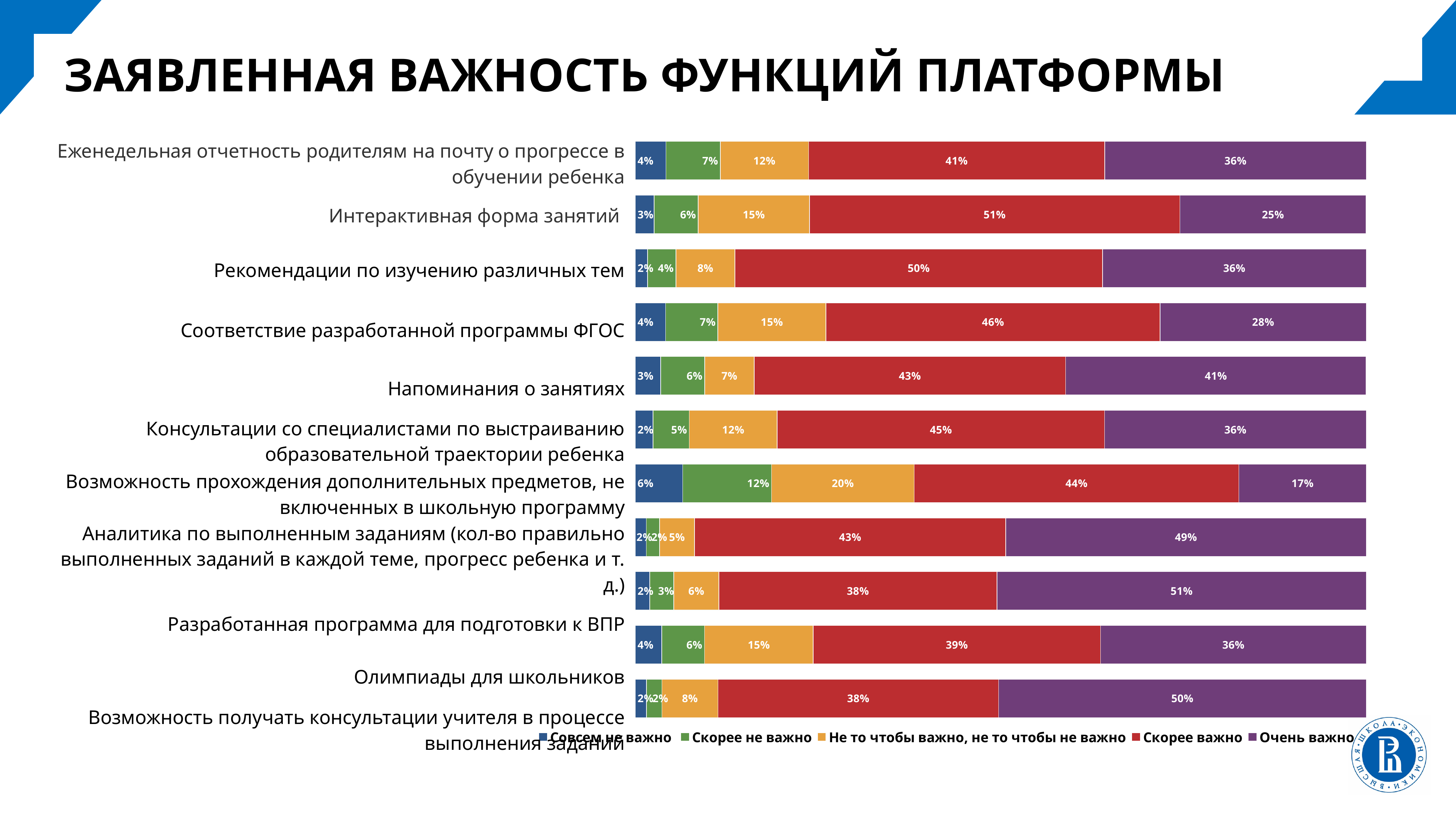
Which function has the highest "Скорее важно" share? Интерактивная форма занятий Which function has the lowest "Очень важно" share? Возможность прохождения дополнительных предметов, не включенных в школьную программу What percentage of respondents rated "Интерактивная форма занятий" as "Очень важно"? 25% How many platform functions are shown in the chart? 11 What type of chart is shown on the slide? Stacked bar chart How many series does the legend list? 5 What is the "Совсем не важно" share for "Возможность прохождения дополнительных предметов, не включенных в школьную программу"? 6% What is the "Не то чтобы важно, не то чтобы не важно" value for "Рекомендации по изучению различных тем"? 8% What is the "Скорее важно" value for "Напоминания о занятиях"? 43% Which has a larger "Очень важно" share: "Напоминания о занятиях" or "Соответствие разработанной программы ФГОС"? Напоминания о занятиях For "Еженедельная отчетность родителям на почту о прогрессе в обучении ребенка", what is the difference between the "Скорее важно" and "Очень важно" shares? 5 percentage points Which function has the highest "Очень важно" share? Разработанная программа для подготовки к ВПР